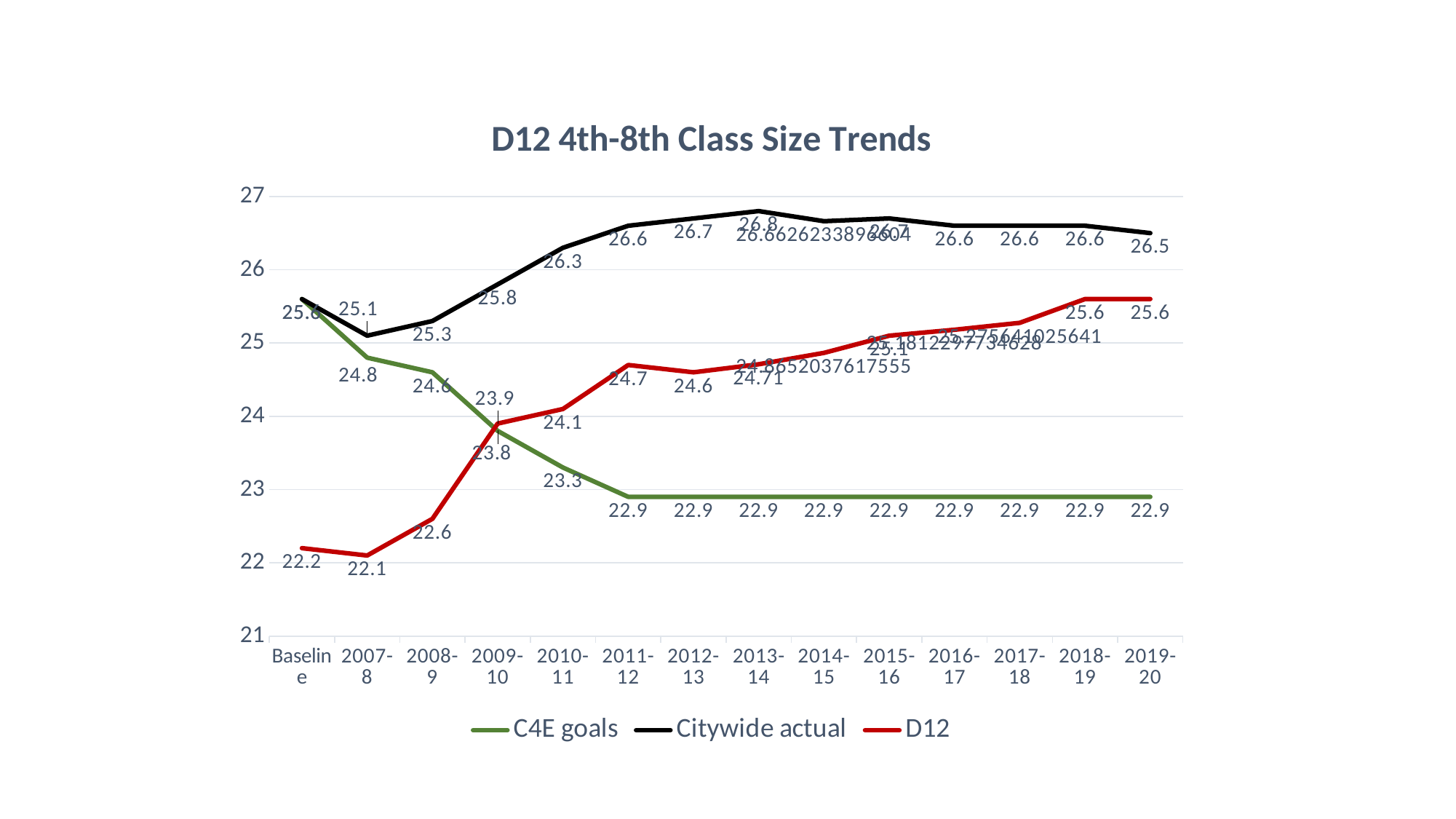
What is the difference between the Citywide actual and D12 values in 2019-20? 0.9 What kind of chart is shown on the slide? line chart How many series does the legend list? 3 How many categories are shown along the x axis? 14 What is the Citywide actual value for 2019-20? 26.5 Does the D12 line generally rise or fall from Baseline to 2019-20? rise What is the D12 value at Baseline? 22.2 In which year is the Citywide actual value lowest? 2007-8 What is the C4E goals value for 2007-8? 24.8 What is the D12 value for 2018-19? 25.6 In 2010-11, which is larger: the D12 value or the C4E goals value? D12 What is the difference between the C4E goals and D12 values in 2008-9? 2.0